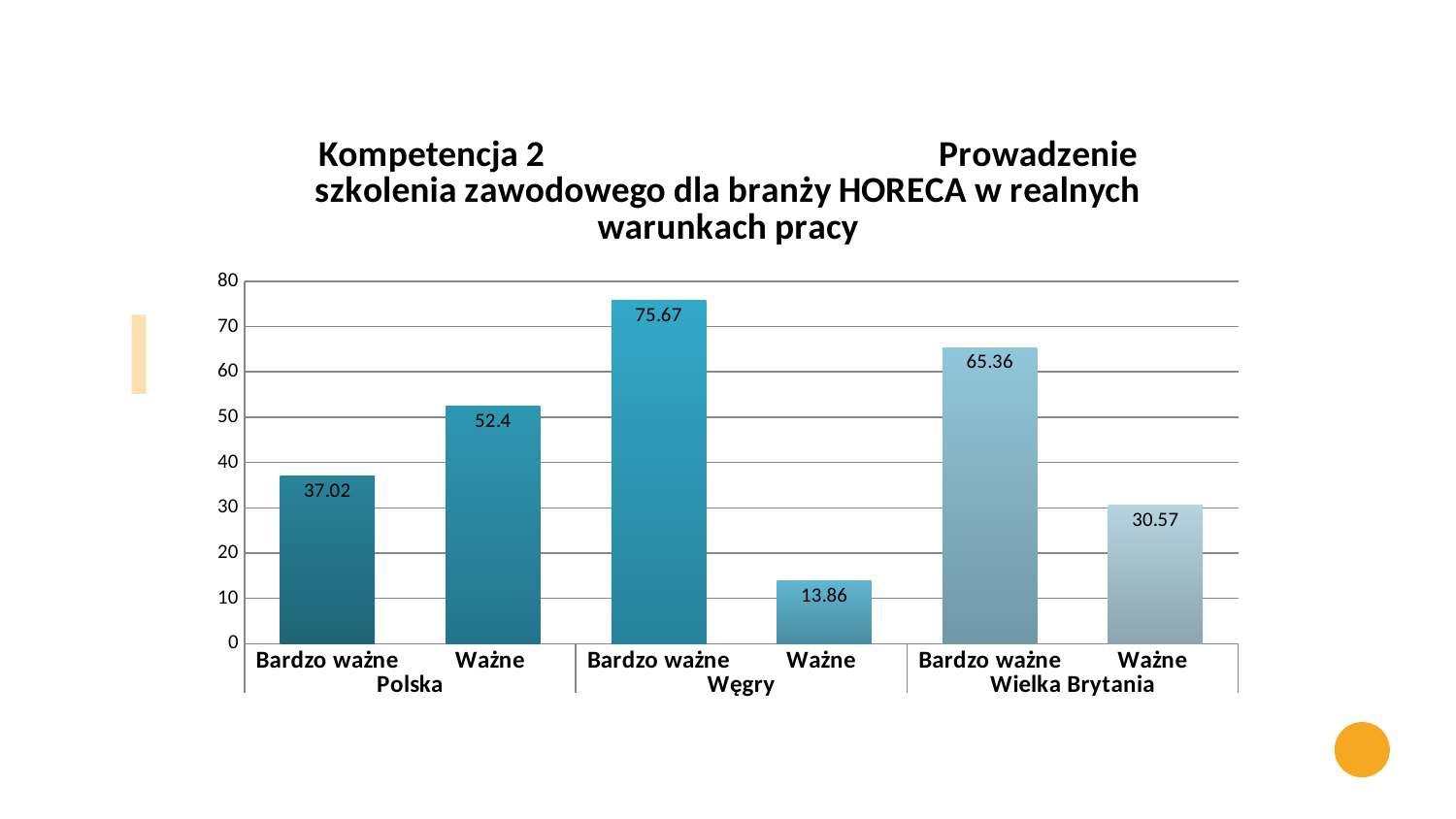
What is the value for "Ważne" in the Węgry group? 13.86 How many bars are plotted on the chart? 6 What kind of chart is shown on the slide? Bar chart Is the value for "Ważne" in the Wielka Brytania group greater or less than 40? less What is the value for "Ważne" in the Polska group? 52.4 How many country groups are shown on the x axis? 3 What is the value for "Bardzo ważne" in the Wielka Brytania group? 65.36 In the Polska group, which is larger: "Bardzo ważne" or "Ważne"? Ważne Which bar has the highest value on the chart? Bardzo ważne (Węgry) What is the difference between "Bardzo ważne" and "Ważne" in the Wielka Brytania group? 34.79 Which bar has the lowest value on the chart? Ważne (Węgry) What is the value for "Bardzo ważne" in the Polska group? 37.02